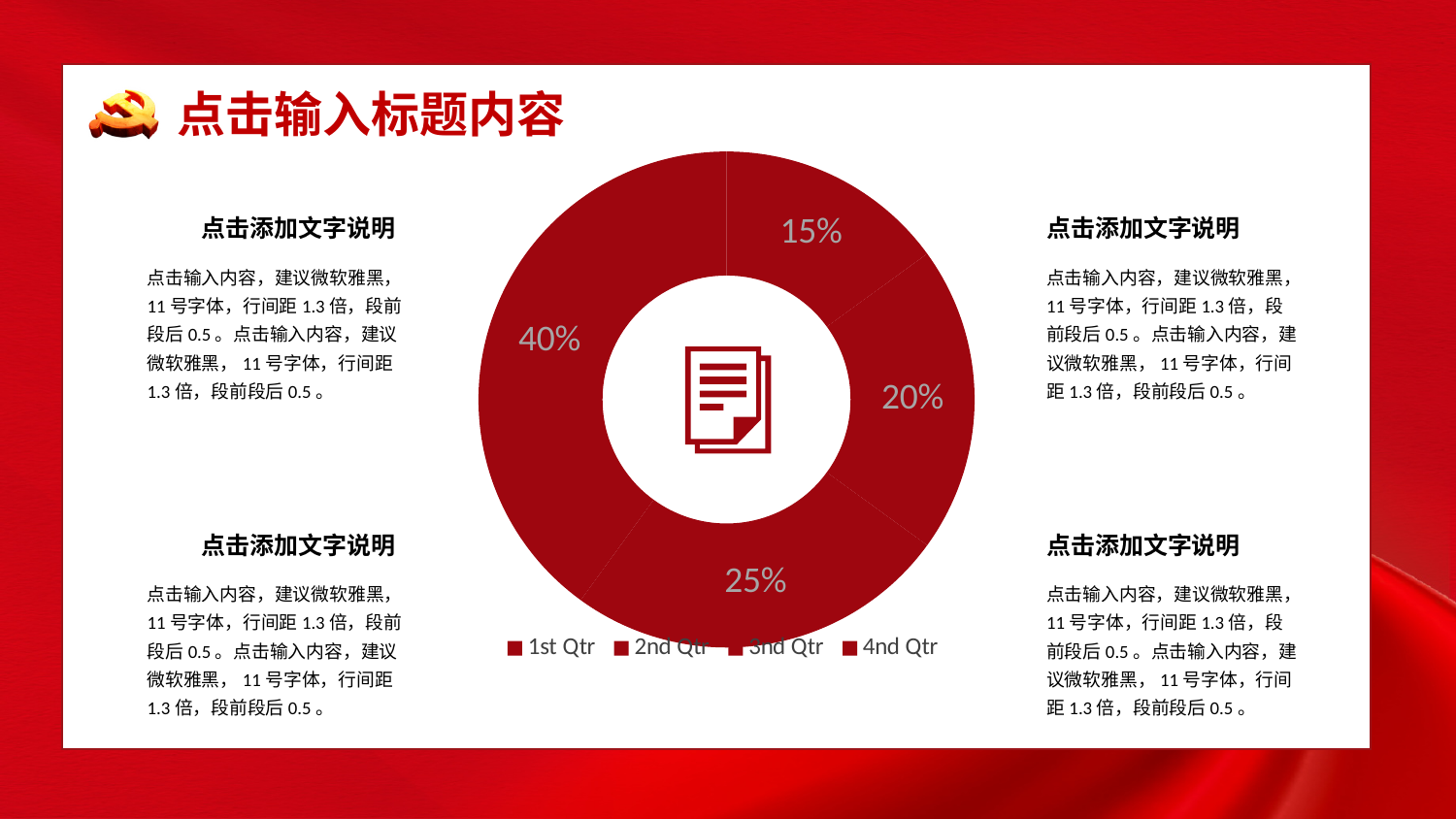
How many entries does the chart legend list? 4 What is the difference between the 25% slice and the 20% slice? 5% What is the smallest percentage shown on the doughnut chart? 15% What is the largest percentage shown on the doughnut chart? 40% What is the difference between the largest and smallest slices of the doughnut chart? 25% Which is larger, the 25% slice or the 20% slice? 25% Is the largest slice of the doughnut chart greater or less than 30%? greater What do the four slice percentages on the doughnut chart add up to? 100% What kind of chart is shown on the slide? doughnut chart How many slices does the doughnut chart have? 4 What is the last entry listed in the chart legend? 4nd Qtr What is the first entry listed in the chart legend? 1st Qtr